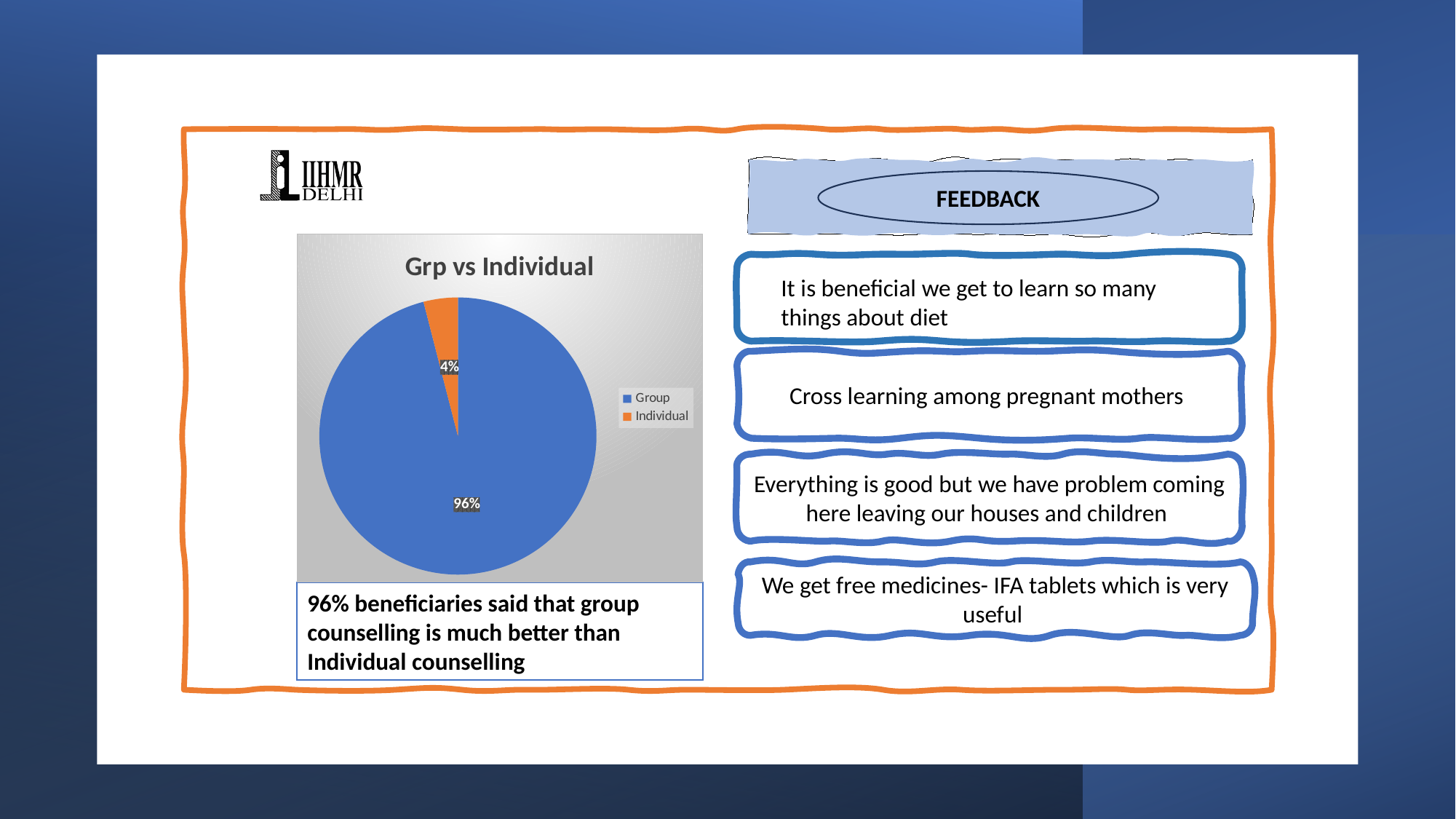
What share of the pie does Group represent? 96% Which category has the largest slice of the pie? Group What colour is the Individual slice in the pie chart? orange What share of the pie does Individual represent? 4% Which is larger, the Group slice or the Individual slice? Group How many entries does the legend list? 2 Which category has the smallest slice of the pie? Individual How many categories does the pie chart show? 2 What is the difference in percentage points between the Group and Individual slices? 92 What kind of chart is shown on the slide? pie chart What is the title of the chart? Grp vs Individual